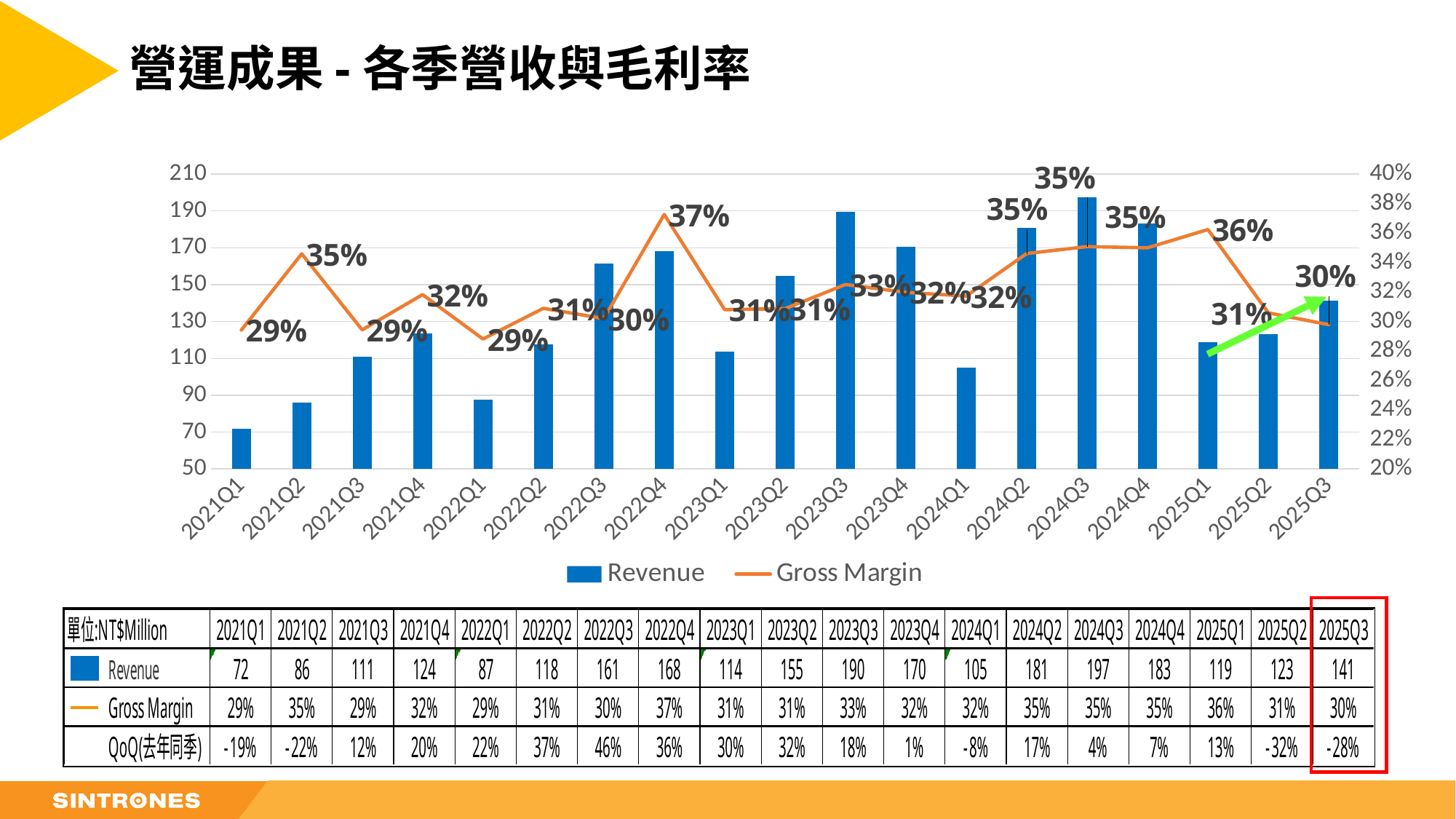
How many quarters are shown on the x axis of the chart? 19 Which quarter has the lowest Revenue? 2021Q1 What is the difference in Revenue between 2024Q3 and 2025Q3? 56 What is the Gross Margin for 2022Q4? 37% How many series does the chart legend list? 2 Does Revenue rise or fall from 2025Q1 to 2025Q3? Rise What kind of chart is used to show Revenue? Bar chart What is the Revenue value for 2025Q3? 141 Is the Revenue for 2022Q3 greater or less than 150? greater Which quarter has higher Revenue, 2023Q3 or 2024Q2? 2023Q3 Which quarter has the highest Gross Margin? 2022Q4 Which quarter has the highest Revenue? 2024Q3